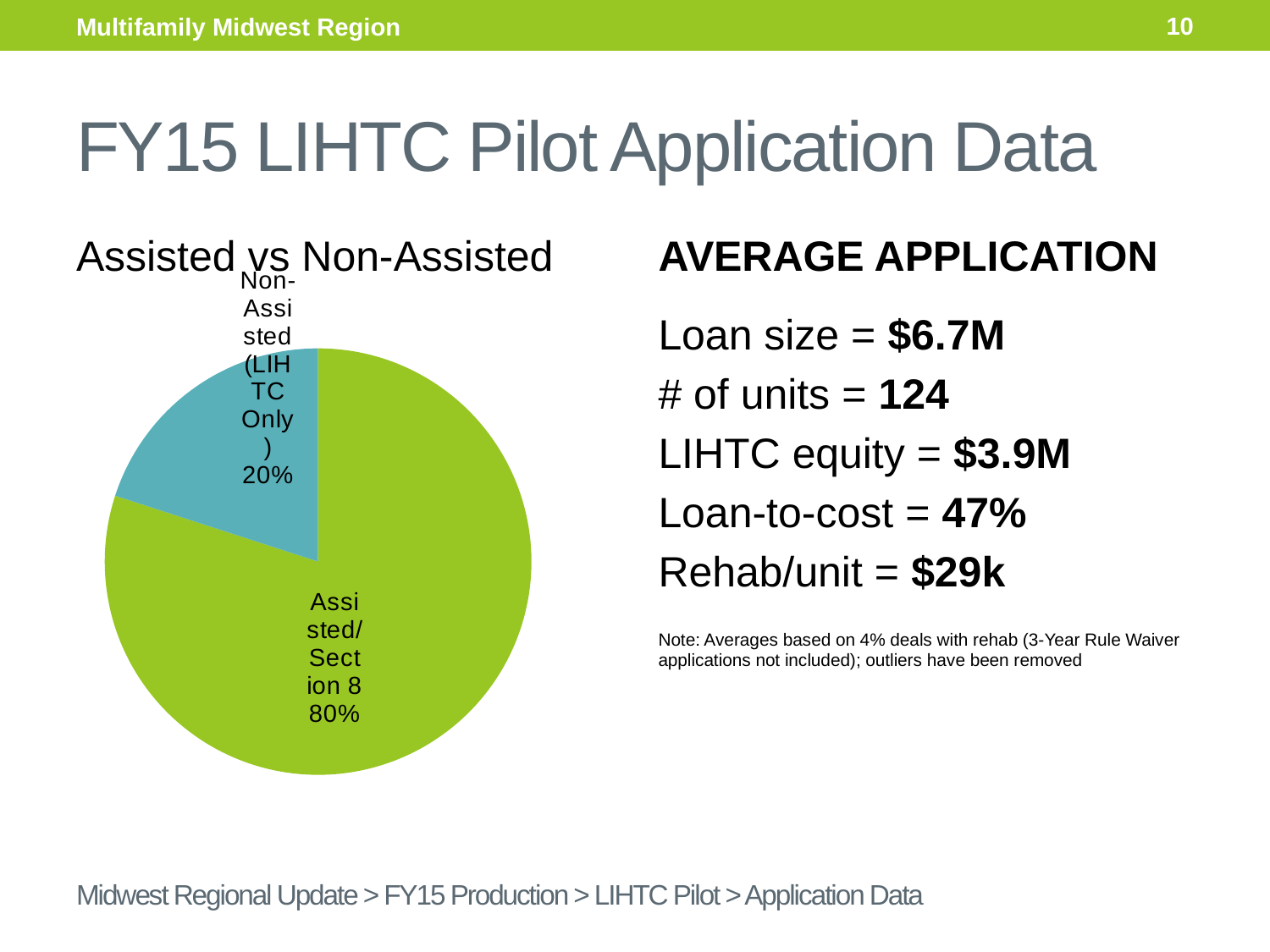
What share of the pie is Non-Assisted (LIHTC Only)? 20% What is the title of the chart? Assisted vs Non-Assisted Which slice of the pie is the largest? Assisted/Section 8 Which slice of the pie is the smallest? Non-Assisted (LIHTC Only) What share of the pie is Assisted/Section 8? 80% Which is larger, the Assisted/Section 8 slice or the Non-Assisted (LIHTC Only) slice? Assisted/Section 8 What type of chart is shown on the slide? pie chart What is the difference in percentage points between the Assisted/Section 8 slice and the Non-Assisted (LIHTC Only) slice? 60 percentage points How many slices does the pie chart have? 2 What colour is the Assisted/Section 8 slice? green